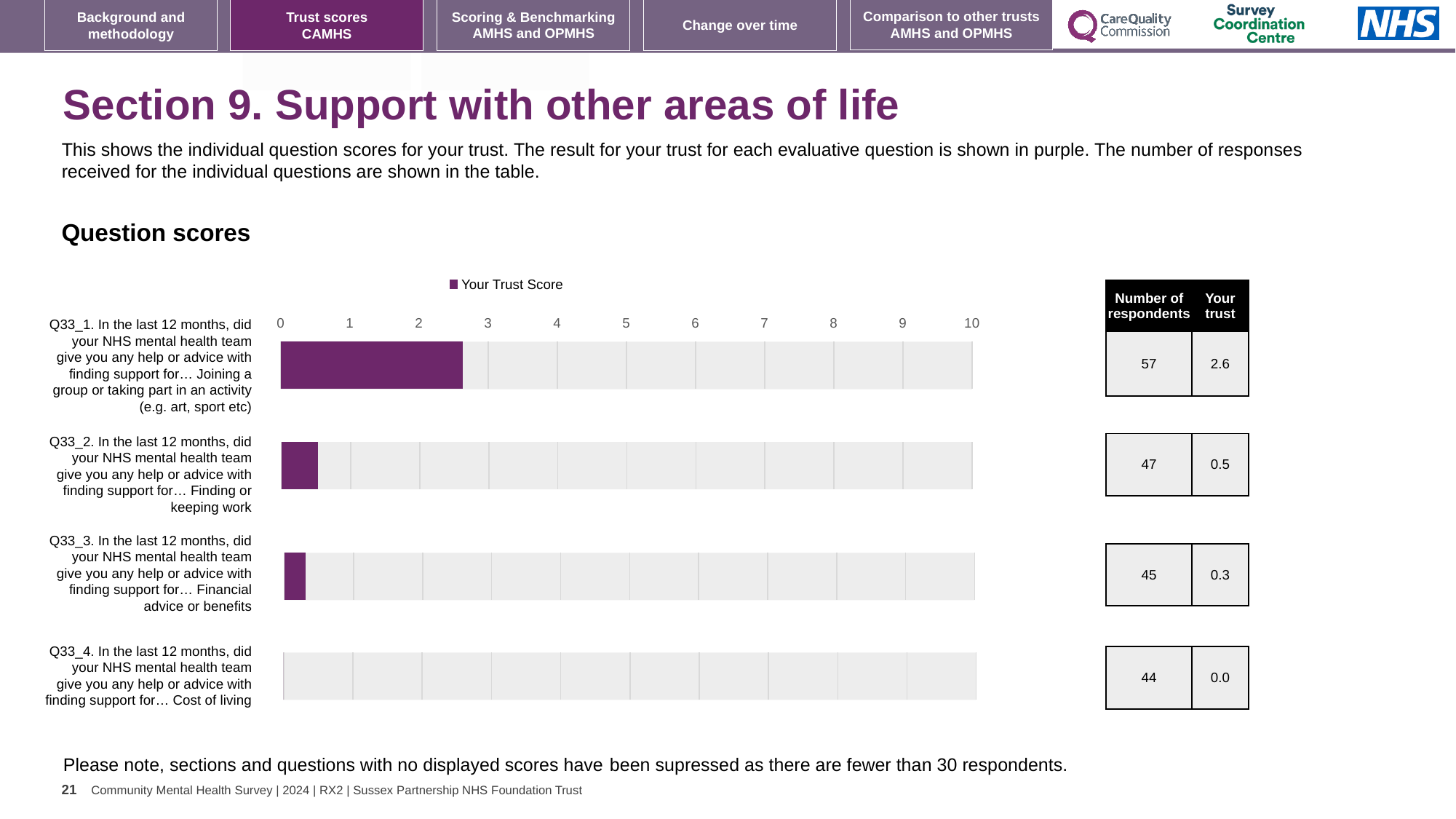
Which question has the highest Your Trust Score? Q33_1 (Joining a group or taking part in an activity) Which has a higher Your Trust Score, Q33_2 (Finding or keeping work) or Q33_3 (Financial advice or benefits)? Q33_2 (Finding or keeping work) What is the difference between the Your Trust Score for Q33_1 and Q33_2? 2.1 What is the Your Trust Score for Q33_2 (Finding or keeping work)? 0.5 Which question has the lowest Your Trust Score? Q33_4 (Cost of living) How many respondents answered Q33_1? 57 How many questions are plotted in the chart? 4 What type of chart is used to show the question scores? Bar chart What is the Your Trust Score for Q33_3 (Financial advice or benefits)? 0.3 Is the Your Trust Score for Q33_1 greater or less than 2? greater What is the Your Trust Score for Q33_1 (Joining a group or taking part in an activity)? 2.6 What is the Your Trust Score for Q33_4 (Cost of living)? 0.0